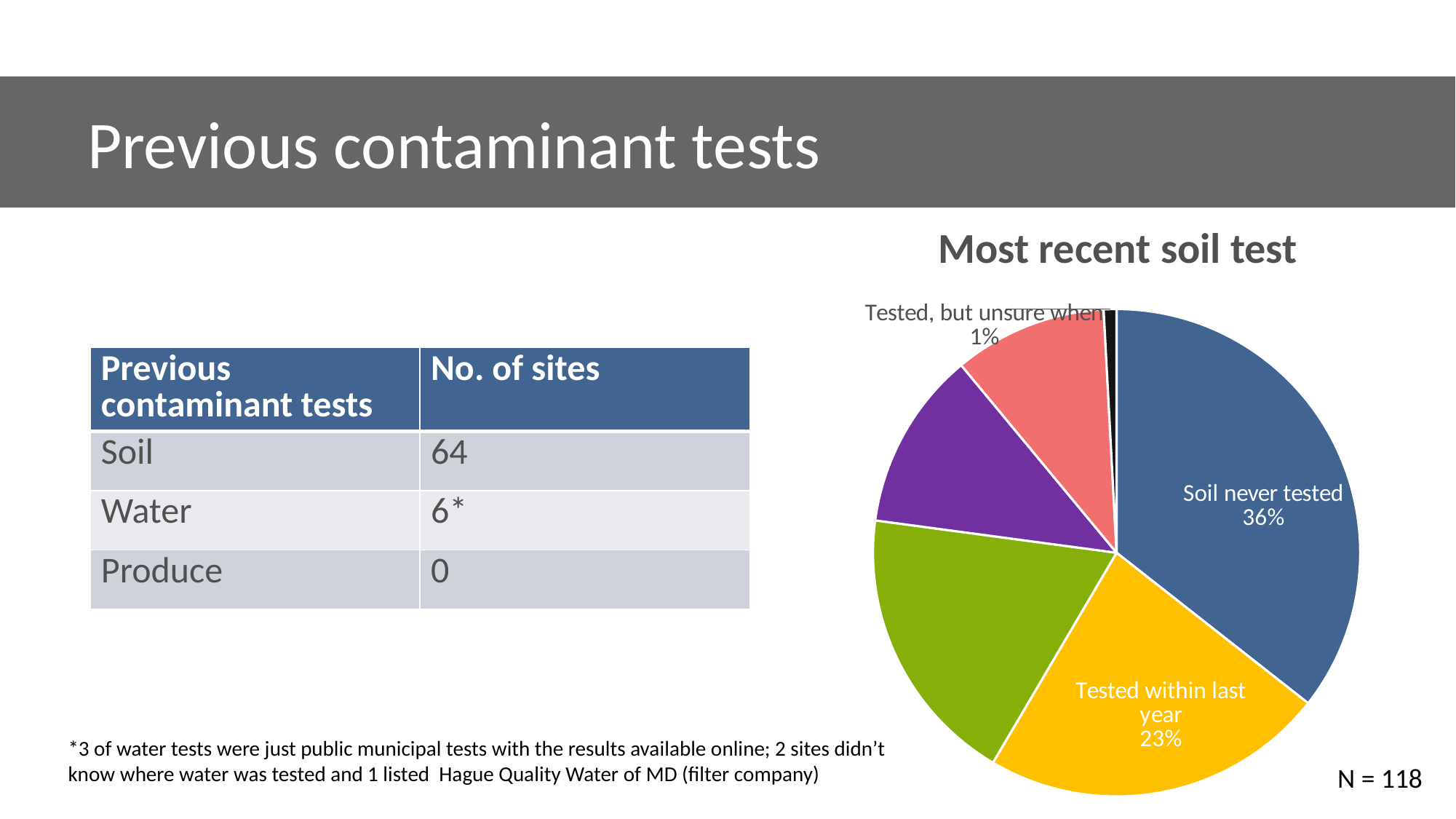
Which slice of the pie chart is the largest? Soil never tested What kind of chart is shown on the slide? Pie chart What percentage of the pie is labelled "Tested within last year"? 23% Which slice of the pie chart is the smallest? Tested, but unsure when What share of the pie does the "Soil never tested" slice represent? 36% What percentage of the pie is labelled "Tested, but unsure when"? 1% Which is larger: the "Soil never tested" slice or the "Tested within last year" slice? Soil never tested What sample size (N) is shown next to the pie chart? N = 118 What is the title of the pie chart? Most recent soil test What is the difference in percentage points between the "Soil never tested" slice and the "Tested within last year" slice? 13 percentage points How many slices does the pie chart have? 6 What percentage of the pie is labelled "Soil never tested"? 36%